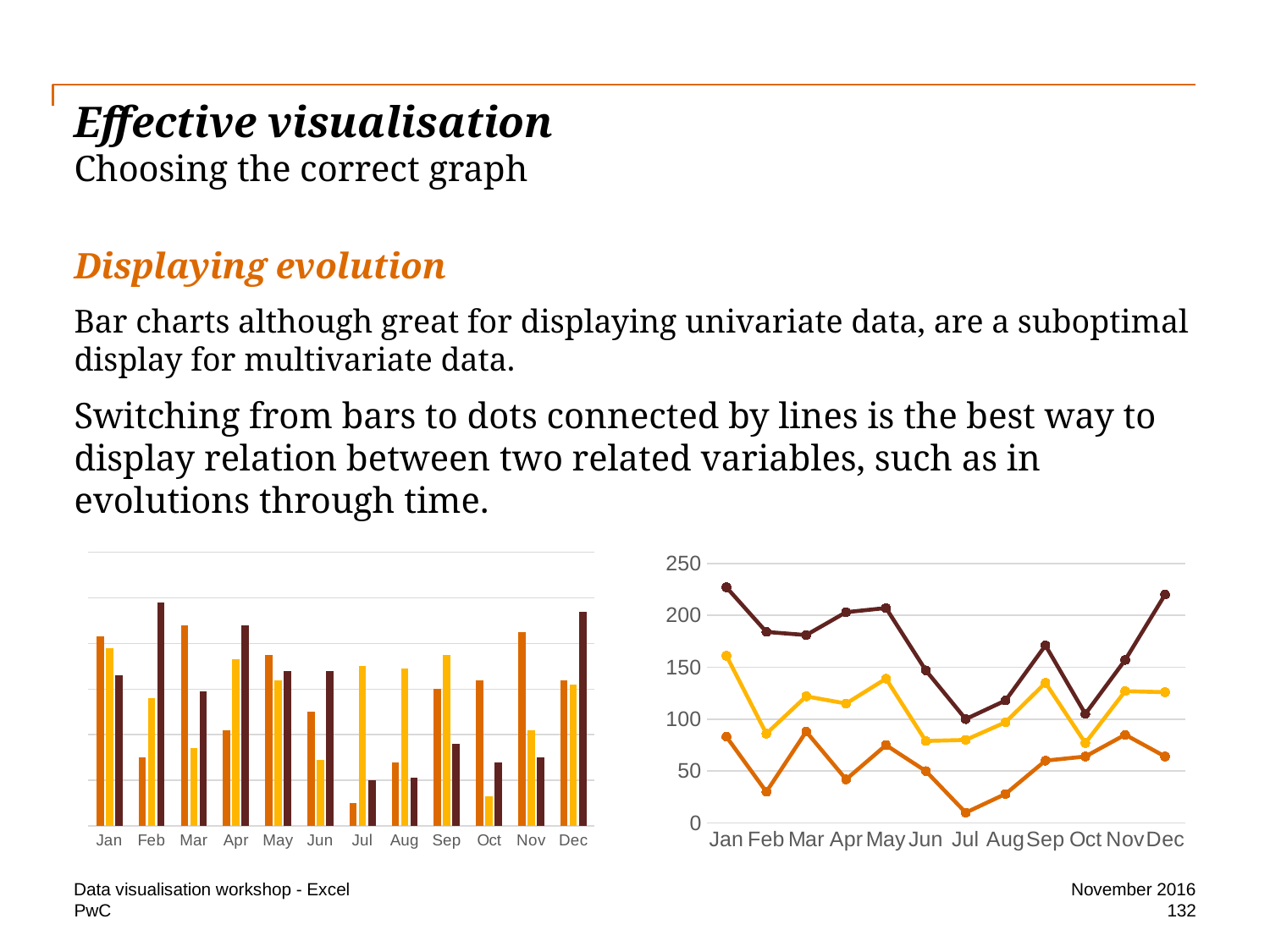
In the line chart on the right, is the value of the yellow line in Feb greater or less than 100? less What type of chart is the chart on the left of the slide? Bar chart What type of chart is the chart on the right of the slide? Line chart In the line chart on the right, is the dark brown line higher in Jan or in Jul? Jan In the line chart on the right, is the value of the orange line in Jul greater or less than 50? less In the bar chart on the left, how many bars are shown for each month? 3 In the line chart on the right, is the value of the dark brown line in Jan greater or less than 200? greater In the line chart on the right, in which month does the yellow line reach its highest value? Jan In the line chart on the right, in which month does the orange line reach its lowest value? Jul In the line chart on the right, how many months are shown on the x axis? 12 In the line chart on the right, how many lines are plotted? 3 In the line chart on the right, does the orange line rise or fall from Jul to Nov? rise